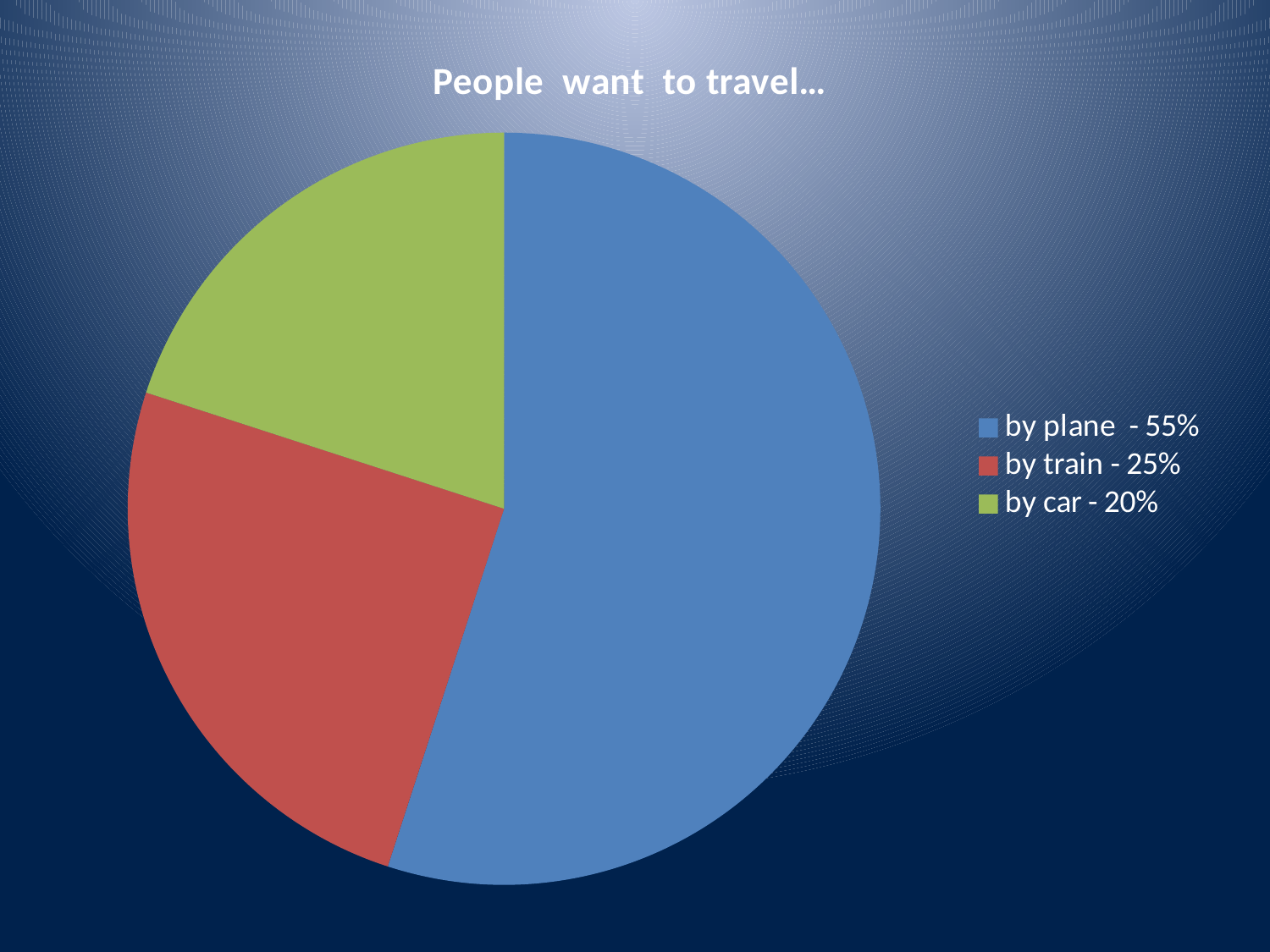
How many slices does the pie chart have? 3 What colour is the slice for travelling by car? green What percentage of people want to travel by car? 20% What percentage of people want to travel by plane? 55% What is the difference in percentage points between travelling by plane and travelling by train? 30 Which is larger, the share for travelling by train or the share for travelling by car? by train What kind of chart is shown on the slide? pie chart Is the share for travelling by plane greater or less than 50%? greater Which mode of travel has the largest share of the pie? by plane What is the title of the chart? People want to travel... What percentage of people want to travel by train? 25% Which mode of travel has the smallest share of the pie? by car